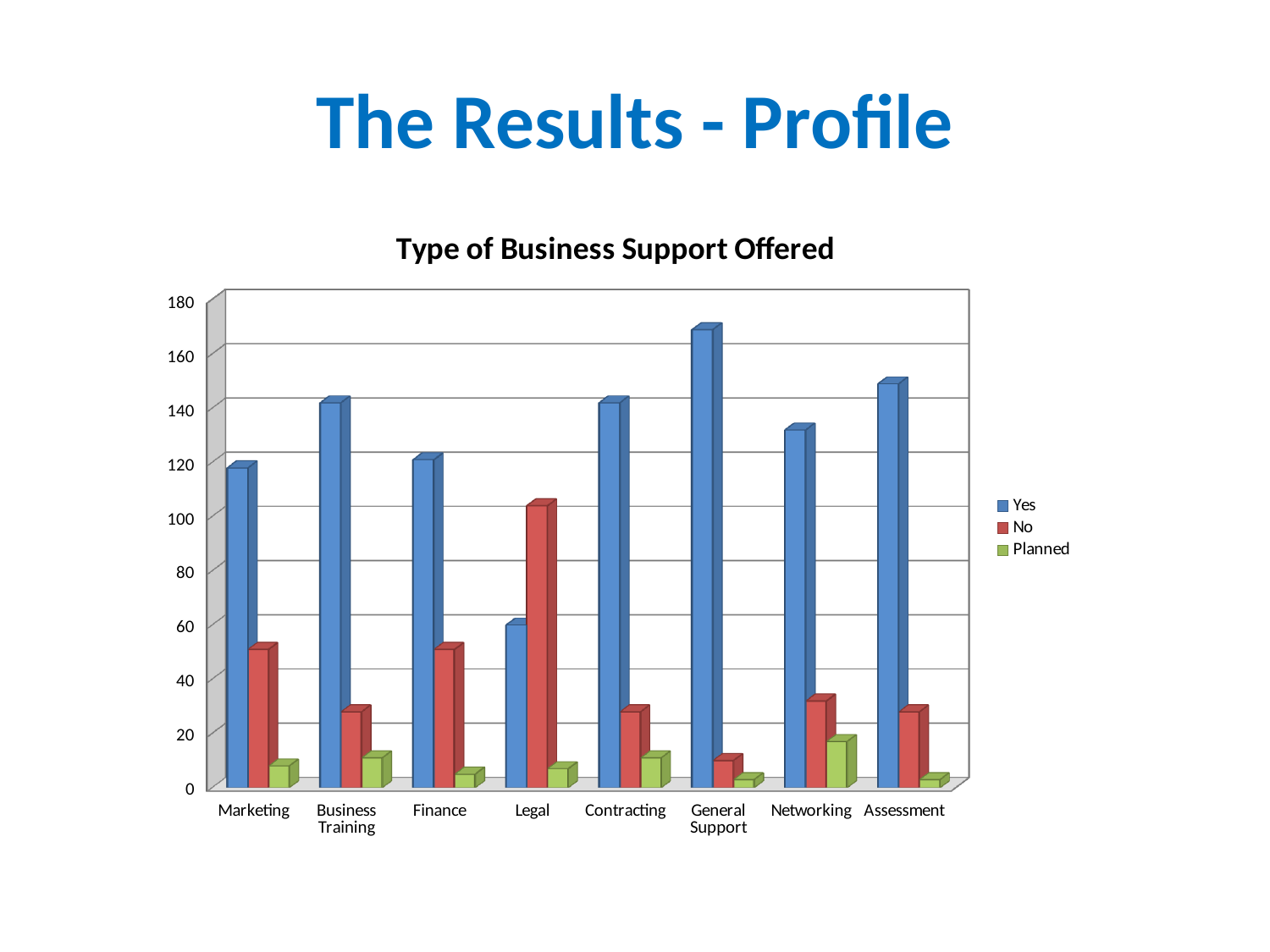
Which type of business support has the highest Planned value? Networking Which type of business support has the highest No value? Legal Which type of business support has the highest Yes value? General Support How many series does the legend list? 3 For Legal, which is larger, the Yes value or the No value? No Is the Yes value for Legal greater or less than 80? less How many types of business support are shown on the x axis? 8 Which type of business support has the lowest No value? General Support What kind of chart is shown on the slide? bar chart Which type of business support has the lowest Yes value? Legal What is the title of the chart? Type of Business Support Offered Is the Yes value for General Support greater or less than 160? greater